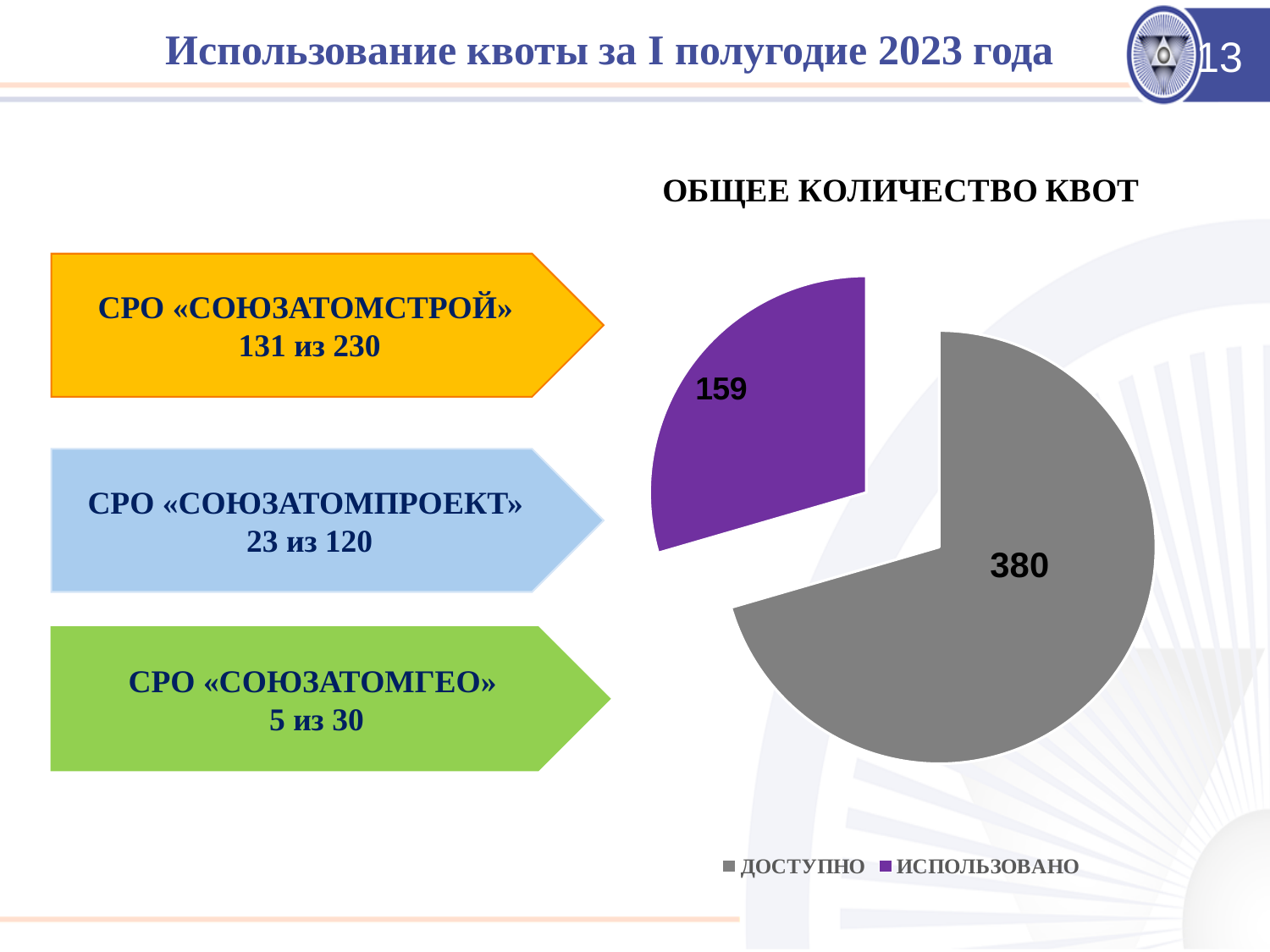
Which slice is the smallest? ИСПОЛЬЗОВАНО What is the total of all slices in the pie chart? 539 What is the value of the ДОСТУПНО slice? 380 What colour is the ИСПОЛЬЗОВАНО slice? purple What kind of chart is shown on the slide? pie chart How many slices does the pie chart have? 2 What is the difference between the ДОСТУПНО and ИСПОЛЬЗОВАНО values? 221 What is the value of the ИСПОЛЬЗОВАНО slice? 159 What is the title of the chart? ОБЩЕЕ КОЛИЧЕСТВО КВОТ Which is larger, ДОСТУПНО or ИСПОЛЬЗОВАНО? ДОСТУПНО Which slice is the largest? ДОСТУПНО How many entries does the legend list? 2